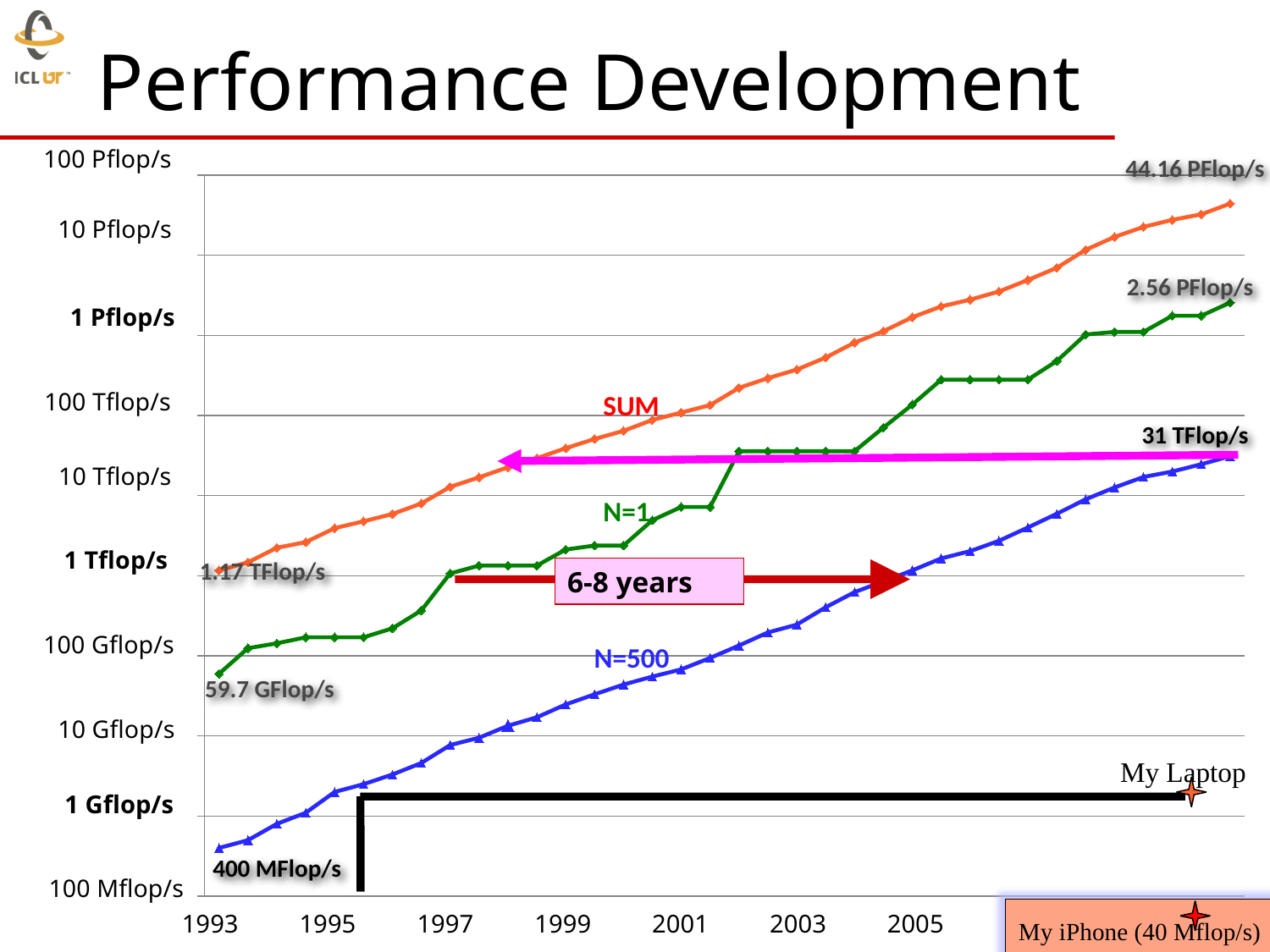
Which series has the highest value at the right end of the chart? SUM What is the final labelled value of the N=1 series? 2.56 PFlop/s What is the labelled starting value of the N=500 series in 1993? 400 MFlop/s In 2001, which series is higher: N=1 or N=500? N=1 What is the labelled starting value of the SUM series in 1993? 1.17 TFlop/s What is the final labelled value of the SUM series? 44.16 PFlop/s Is the SUM value in 2003 greater or less than 100 Tflop/s? greater What is the final labelled value of the N=500 series? 31 TFlop/s How many data series are plotted on the chart? 3 Does the N=500 series rise or fall over time along the x axis? rise What kind of chart is shown on the slide? line chart What is the labelled starting value of the N=1 series in 1993? 59.7 GFlop/s